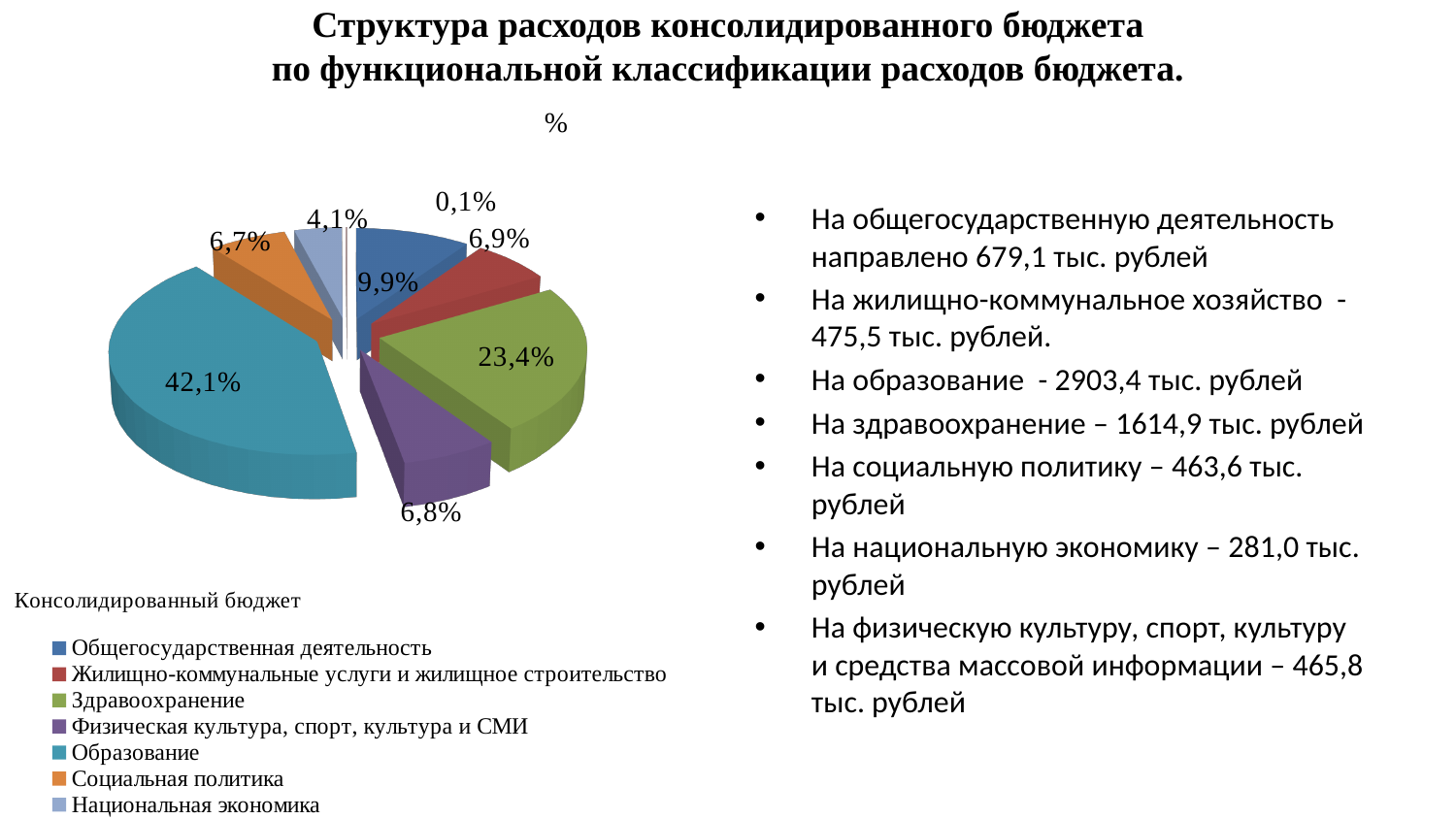
What share of the pie does Образование have? 42,1% How many entries does the chart legend list? 7 Which is larger, the share for Здравоохранение or the share for Общегосударственная деятельность? Здравоохранение What is the title of the chart legend? Консолидированный бюджет What is the value for Здравоохранение? 23,4% What type of chart is shown on the slide? pie chart What is the value for Национальная экономика? 4,1% Which category has the largest share of the pie? Образование What is the smallest percentage shown on the pie chart? 0,1% What is the difference between the shares for Образование and Здравоохранение? 18,7% What is the value for Общегосударственная деятельность? 9,9% What is the value for Социальная политика? 6,7%